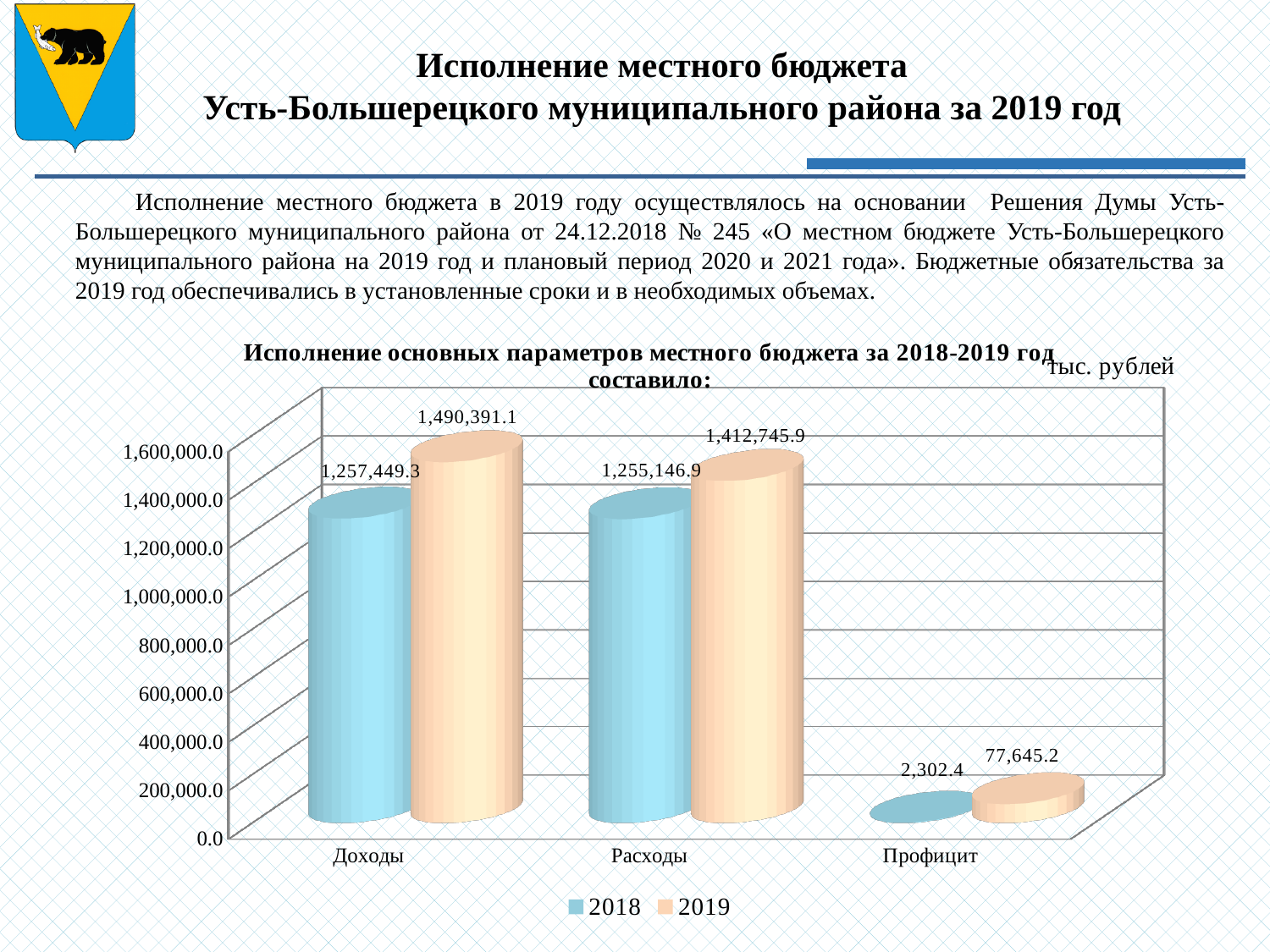
What is the value for Расходы in the 2018 series? 1,255,146.9 What kind of chart is shown on the slide? Bar chart How many categories are shown on the x axis? 3 Which category has the lowest value in the 2018 series? Профицит How many series does the legend list? 2 What is the value for Профицит in the 2018 series? 2,302.4 What is the difference between the 2019 and 2018 values for Доходы? 232,941.8 Which is larger: Доходы in 2019 or Расходы in 2019? Доходы in 2019 Which category has the highest value in the 2019 series? Доходы What is the value for Доходы in the 2019 series? 1,490,391.1 What is the difference between the 2019 and 2018 values for Расходы? 157,599.0 What is the value for Профицит in the 2019 series? 77,645.2